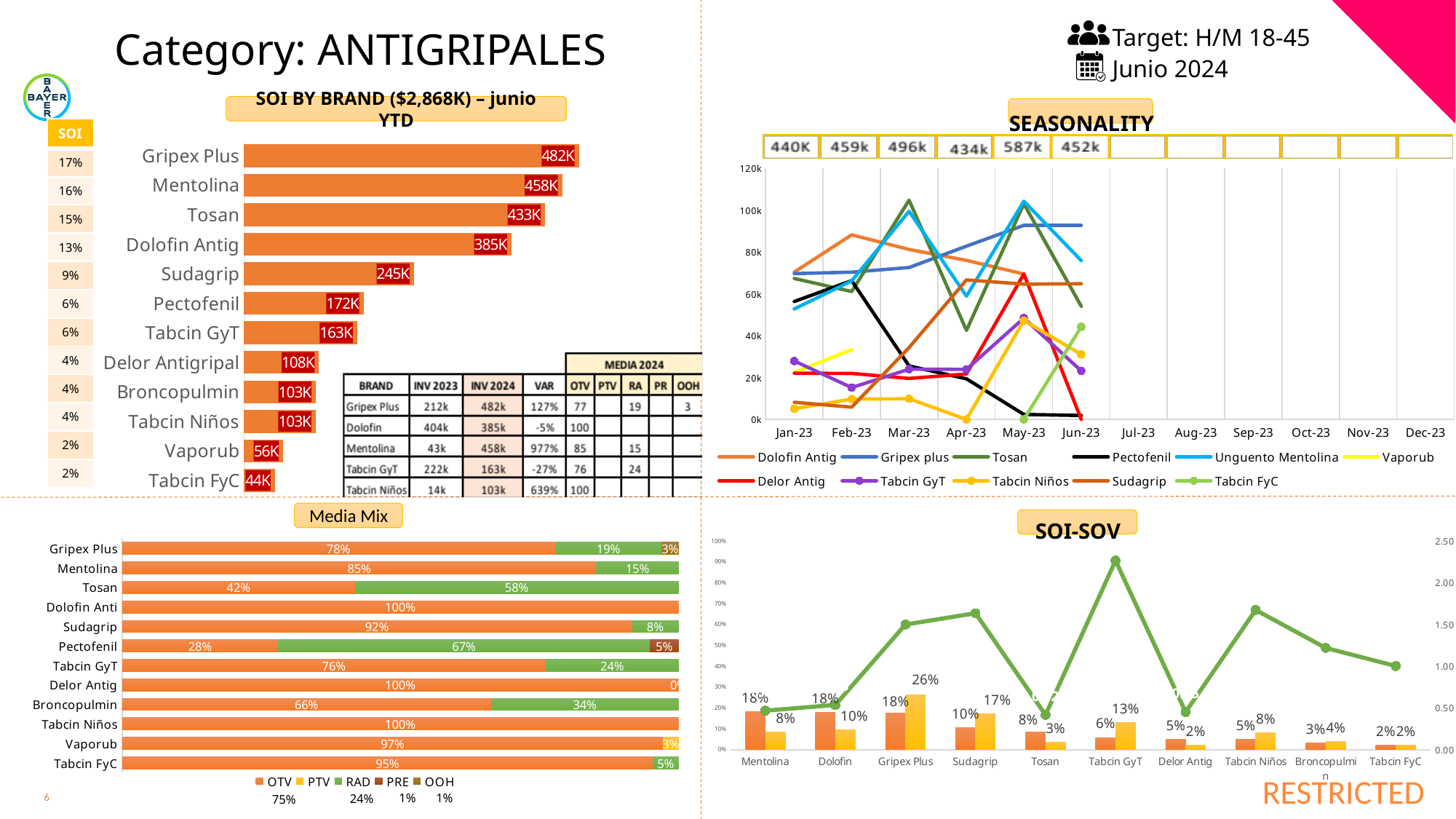
In the Media Mix chart, how many series does the legend list? 5 In the SOI BY BRAND chart, which is larger, Sudagrip or Pectofenil? Sudagrip In the SOI-SOV chart, at which brand does the green line reach its highest point? Tabcin GyT In the SOI BY BRAND chart, how many brands are shown? 12 In the SOI BY BRAND chart, what is the value for Gripex Plus? 482K In the SEASONALITY chart, is the value for Tosan in Mar-23 greater or less than 80k? greater What kind of chart is the SEASONALITY chart? Line chart In the SOI-SOV chart, what is the second (yellow) bar value for Gripex Plus? 26% In the SOI BY BRAND chart, what is the difference between Mentolina and Tosan? 25K In the SEASONALITY chart, how many series does the legend list? 11 In the SOI BY BRAND chart, which brand has the lowest value? Tabcin FyC In the Media Mix chart, what is the OTV share for Tosan? 42%